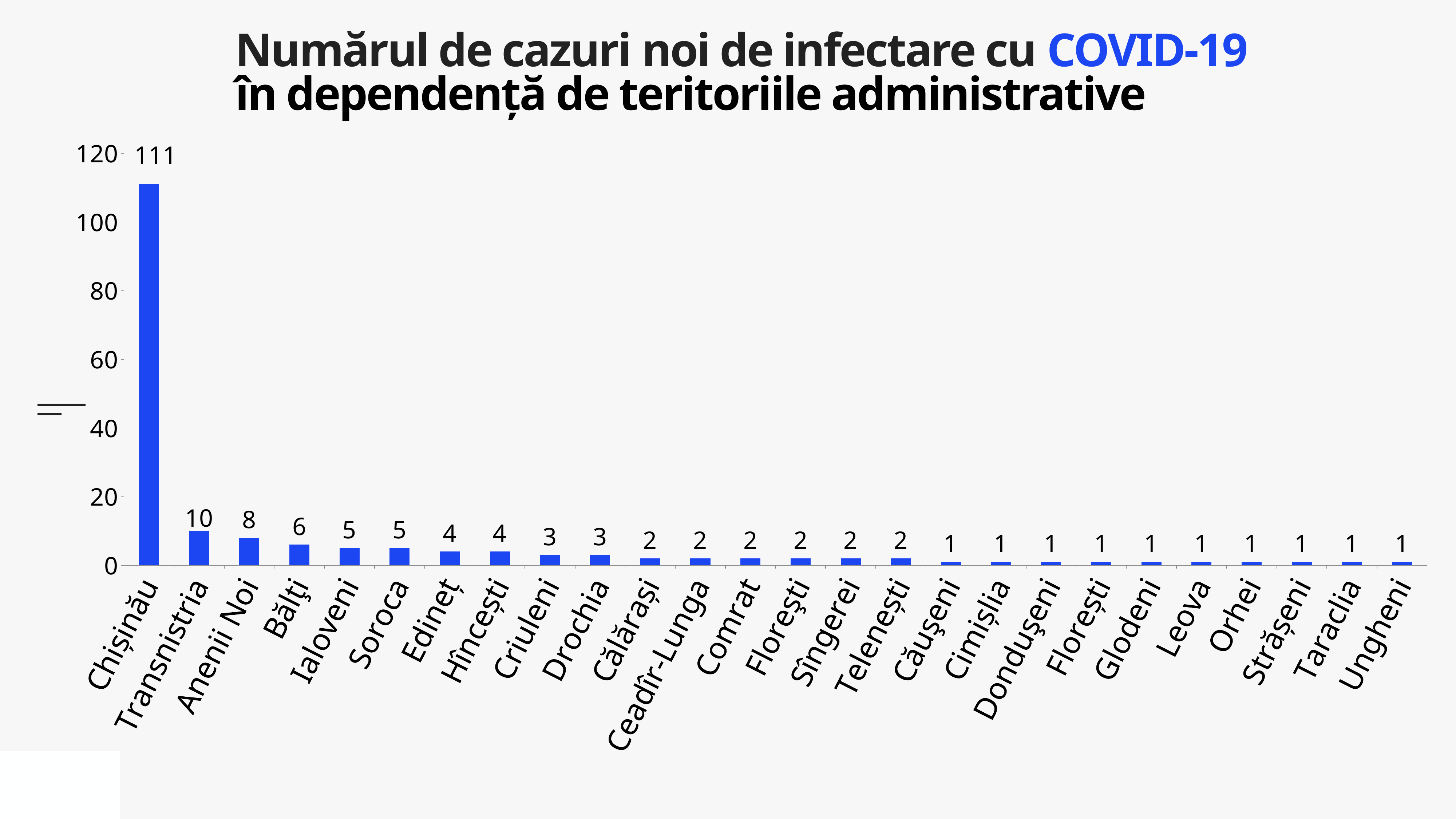
What is the value for Bălți? 6 How many territories are shown on the x axis? 26 What is the value for Anenii Noi? 8 Which territory has the highest number of new cases? Chișinău What kind of chart is shown on the slide? bar chart Is the value for Chișinău greater or less than 100? greater What is the difference between the values for Chișinău and Transnistria? 101 Which is larger, the value for Ialoveni or the value for Edineț? Ialoveni What is the value for Transnistria? 10 What is the value for Chișinău? 111 What is the difference between the values for Anenii Noi and Bălți? 2 What is the value for Drochia? 3